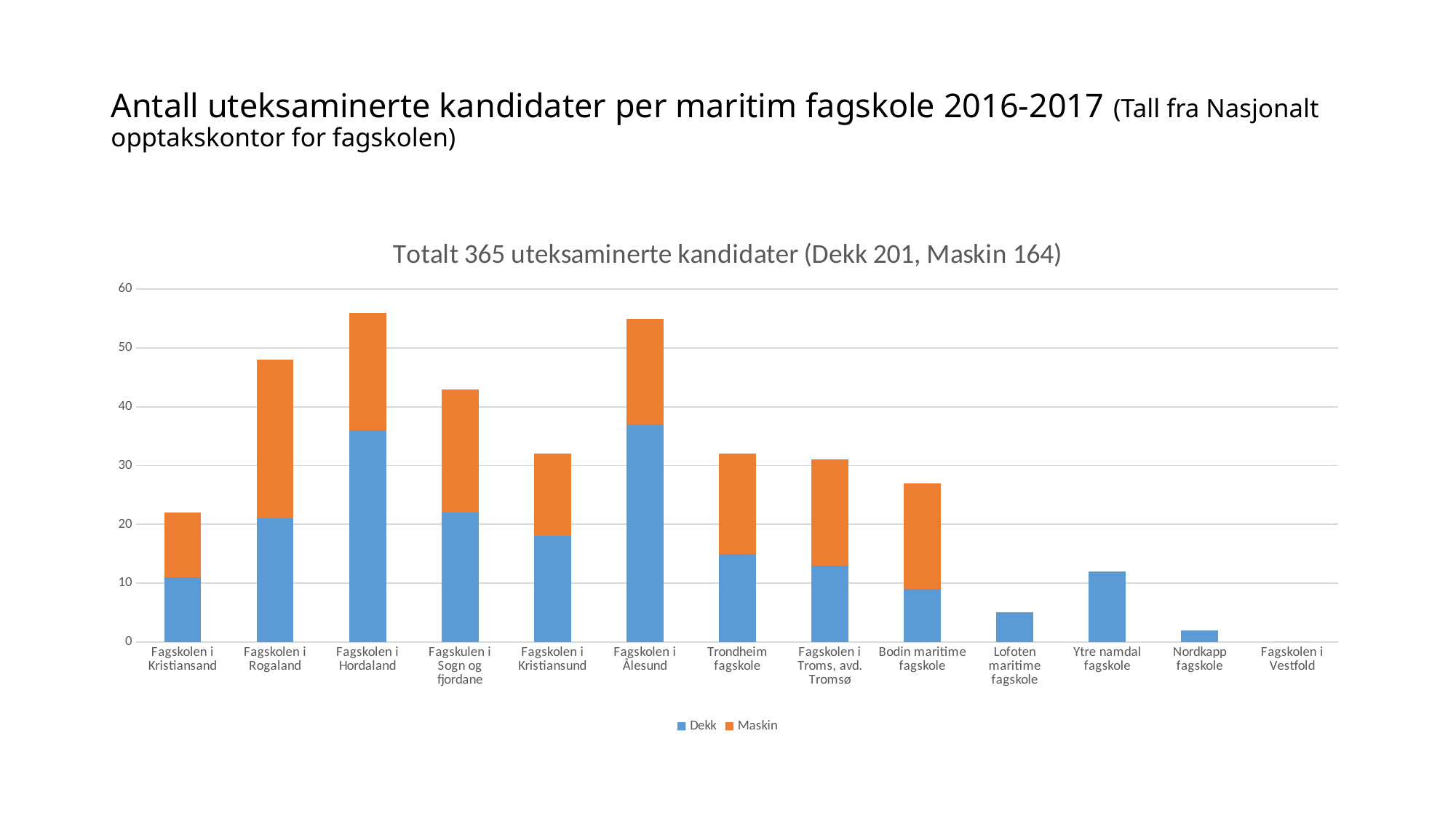
What kind of chart is shown on the slide? stacked bar chart According to the chart title, how many Dekk candidates graduated in total? 201 Which colour represents the Maskin series in the chart? orange Which has the larger bar, Ytre namdal fagskole or Lofoten maritime fagskole? Ytre namdal fagskole Is the Dekk value for Fagskolen i Ålesund greater or less than 30? greater Is the total bar for Fagskolen i Hordaland greater or less than 50? greater Which school has the lowest total, with no visible bar at all? Fagskolen i Vestfold Which has the larger total bar, Fagskolen i Rogaland or Fagskolen i Kristiansand? Fagskolen i Rogaland Is the total bar for Fagskolen i Kristiansand greater or less than 30? less How many schools (categories) are shown on the x axis? 13 How many series does the legend list? 2